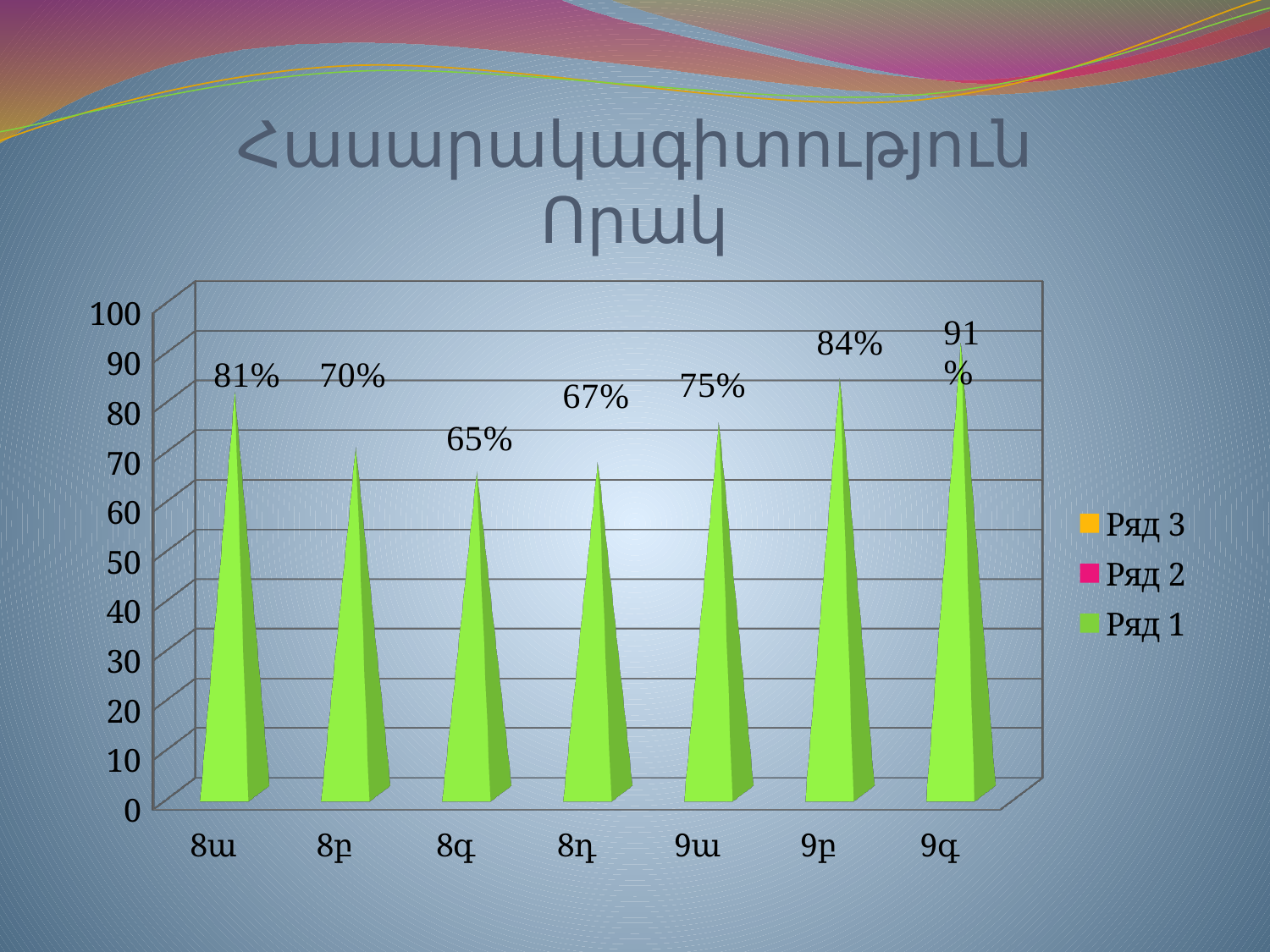
What is the value for 9բ? 84% What is the difference between the values for 9գ and 8ա? 10% Which is larger, the value for 8բ or the value for 9ա? 9ա How many categories are shown on the x axis? 7 Which category has the highest value? 9գ What kind of chart is shown on the slide? bar chart Which category has the lowest value? 8գ What is the value for 8ա? 81% How many series does the legend list? 3 What is the title of the chart? Հասարակագիտություն Որակ Is the value for 8դ greater or less than 60? greater What is the value for 8գ? 65%